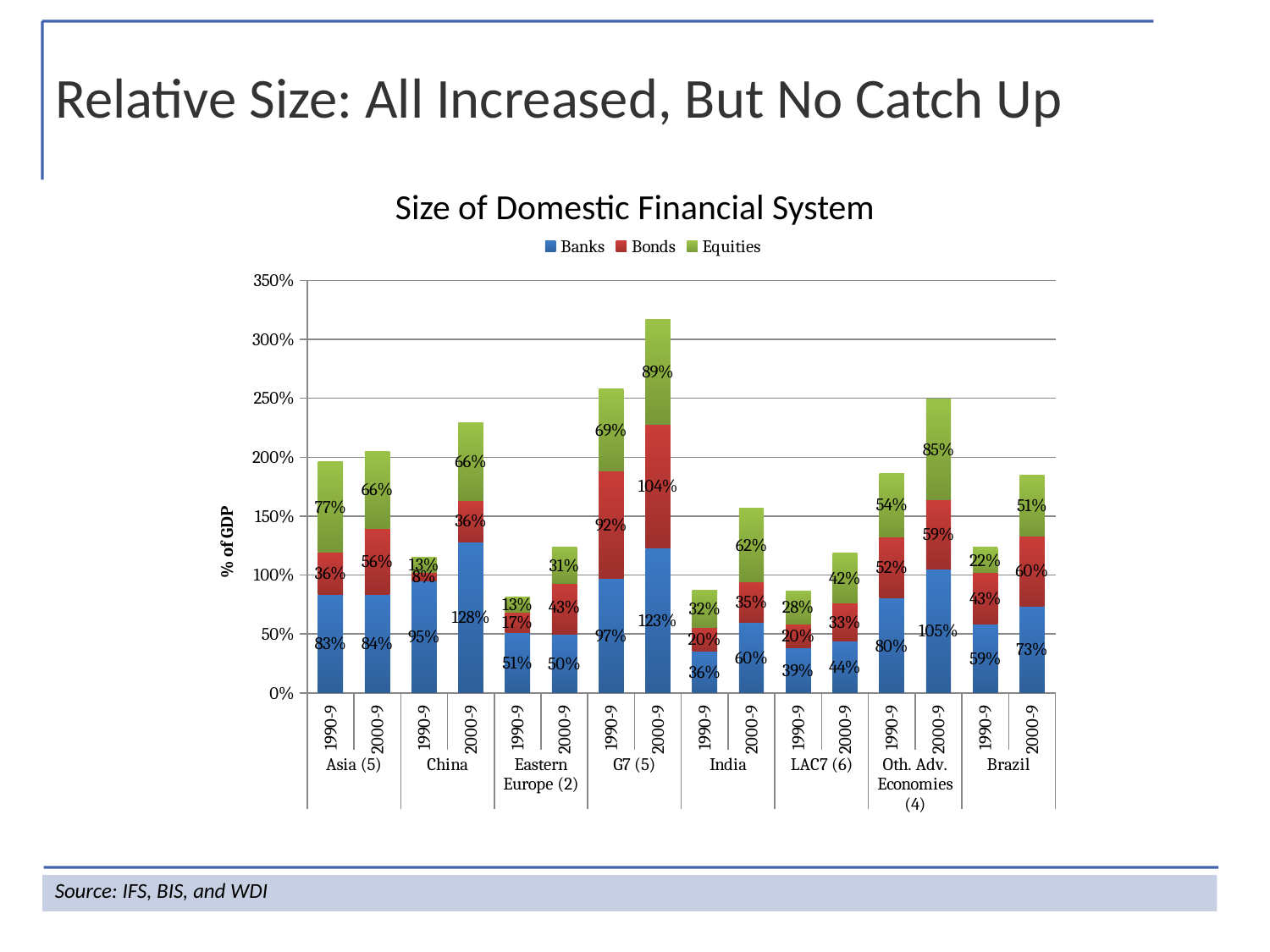
What is the Banks value for China in 2000-9? 128% Which is larger, the Equities value for Asia (5) in 1990-9 or for Oth. Adv. Economies (4) in 2000-9? Oth. Adv. Economies (4) in 2000-9 What is the Equities value for G7 (5) in 2000-9? 89% Which bar has the highest Banks value? China 2000-9 What is the difference between the Banks value for India in 2000-9 and in 1990-9? 24% What is the Bonds value for Brazil in 1990-9? 43% What is the total of the stacked bar for LAC7 (6) in 2000-9? 119% Which bar has the lowest Bonds value? China 1990-9 How many series does the legend list? 3 How many stacked bars are plotted in the chart? 16 Is the total stacked value for G7 (5) in 2000-9 greater or less than 300%? greater What type of chart is shown on the slide? Stacked bar chart